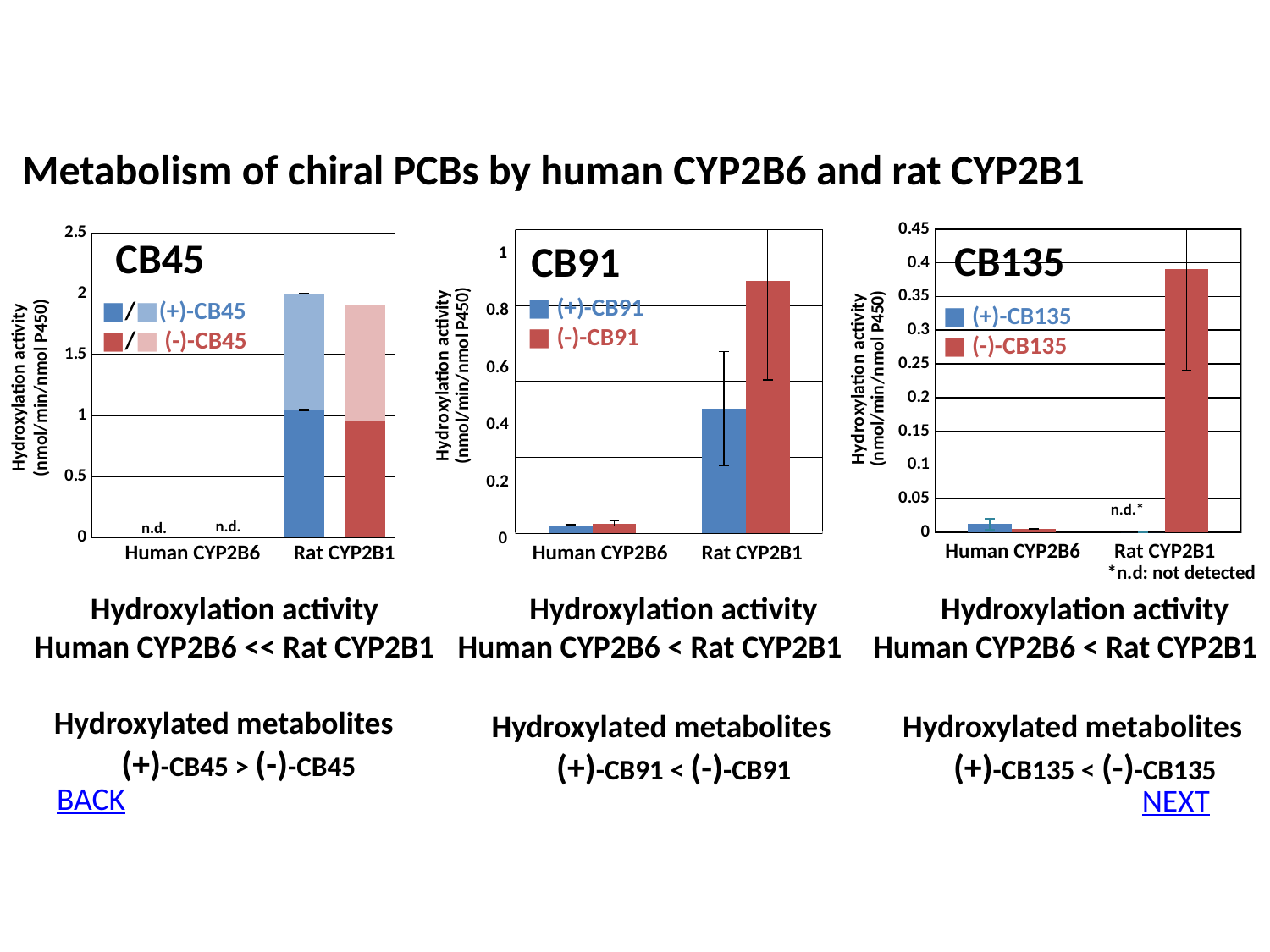
In the CB135 chart, which series is marked n.d. at Rat CYP2B1? (+)-CB135 What kind of chart is the CB91 chart? bar chart In the CB135 chart, is the value for (-)-CB135 at Rat CYP2B1 greater or less than 0.35? greater In the CB91 chart, is the value for (+)-CB91 at Rat CYP2B1 greater or less than 0.6? less In the CB91 chart, is the value for (-)-CB91 at Rat CYP2B1 greater or less than 0.8? greater In the CB45 chart, what is shown for both series at Human CYP2B6? n.d. What is the y-axis label of the CB45 chart? Hydroxylation activity (nmol/min/nmol P450) How many categories are shown on the x axis of the CB135 chart? 2 In the CB91 chart, which category has the lower values, Human CYP2B6 or Rat CYP2B1? Human CYP2B6 How many series does the legend of the CB91 chart list? 2 In the CB135 chart, which bar is the highest? (-)-CB135 at Rat CYP2B1 In the CB91 chart, which is larger at Rat CYP2B1, (+)-CB91 or (-)-CB91? (-)-CB91